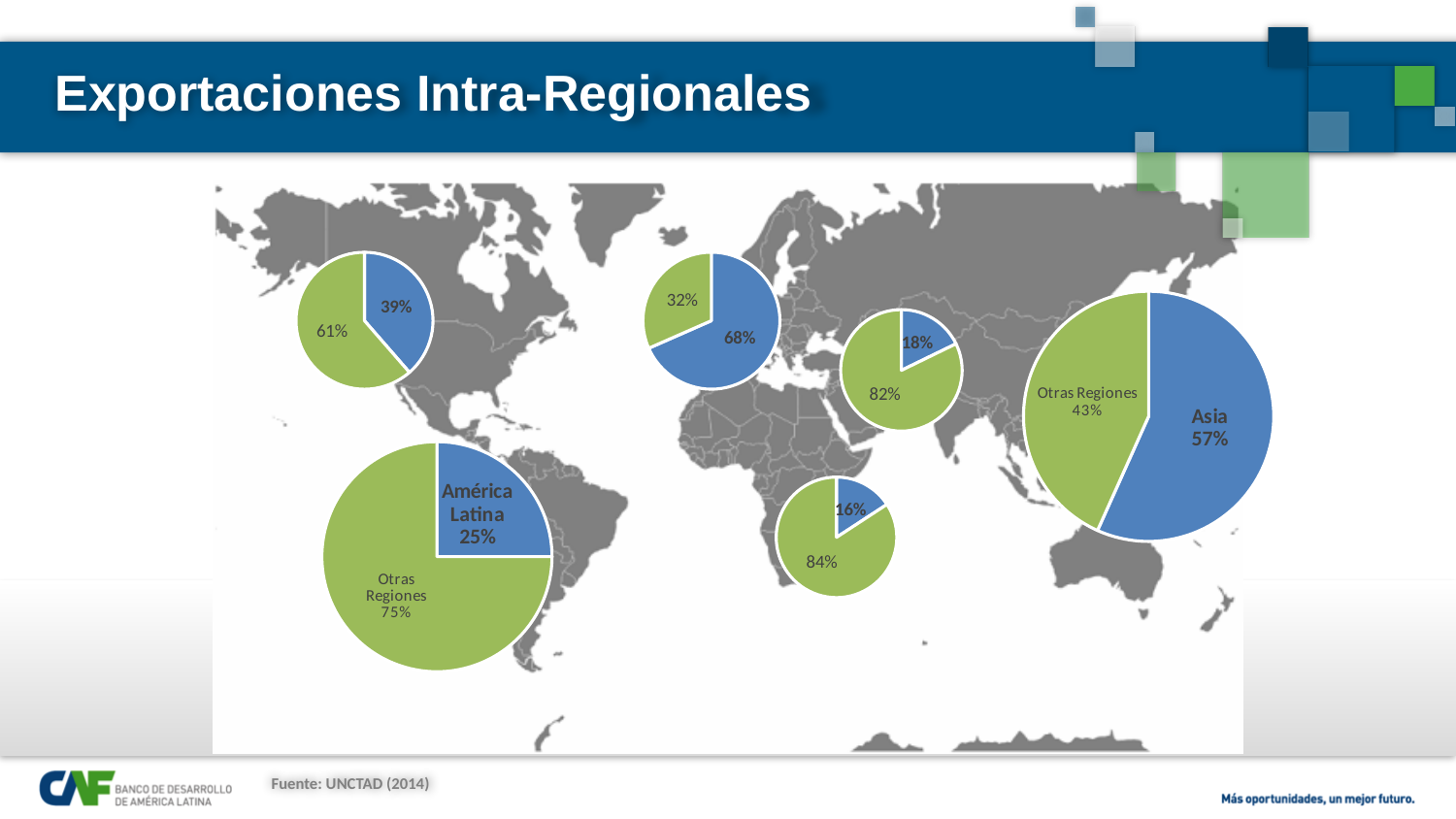
In the pie chart placed over Africa, what percentage is shown on the green slice? 84% In the pie chart placed over North America, what are the two percentages shown? 39% and 61% In the pie chart labelled 'América Latina', what is the difference between the 'Otras Regiones' share and the 'América Latina' share? 50 percentage points In the pie chart placed over Europe, what percentage is shown on the blue slice? 68% In the pie chart labelled 'América Latina', what share of exports goes to América Latina? 25% How many pie charts are placed on the map on this slide? 6 What kind of charts are placed on the map on this slide? Pie charts In the pie chart labelled 'Asia', what share of exports goes to Asia? 57% In the pie chart placed over the Middle East, what percentage is shown on the blue slice? 18% In the pie chart labelled 'América Latina', what share is labelled 'Otras Regiones'? 75% In the pie chart labelled 'Asia', which slice is larger, 'Asia' or 'Otras Regiones'? Asia In the pie chart labelled 'Asia', what share is labelled 'Otras Regiones'? 43%